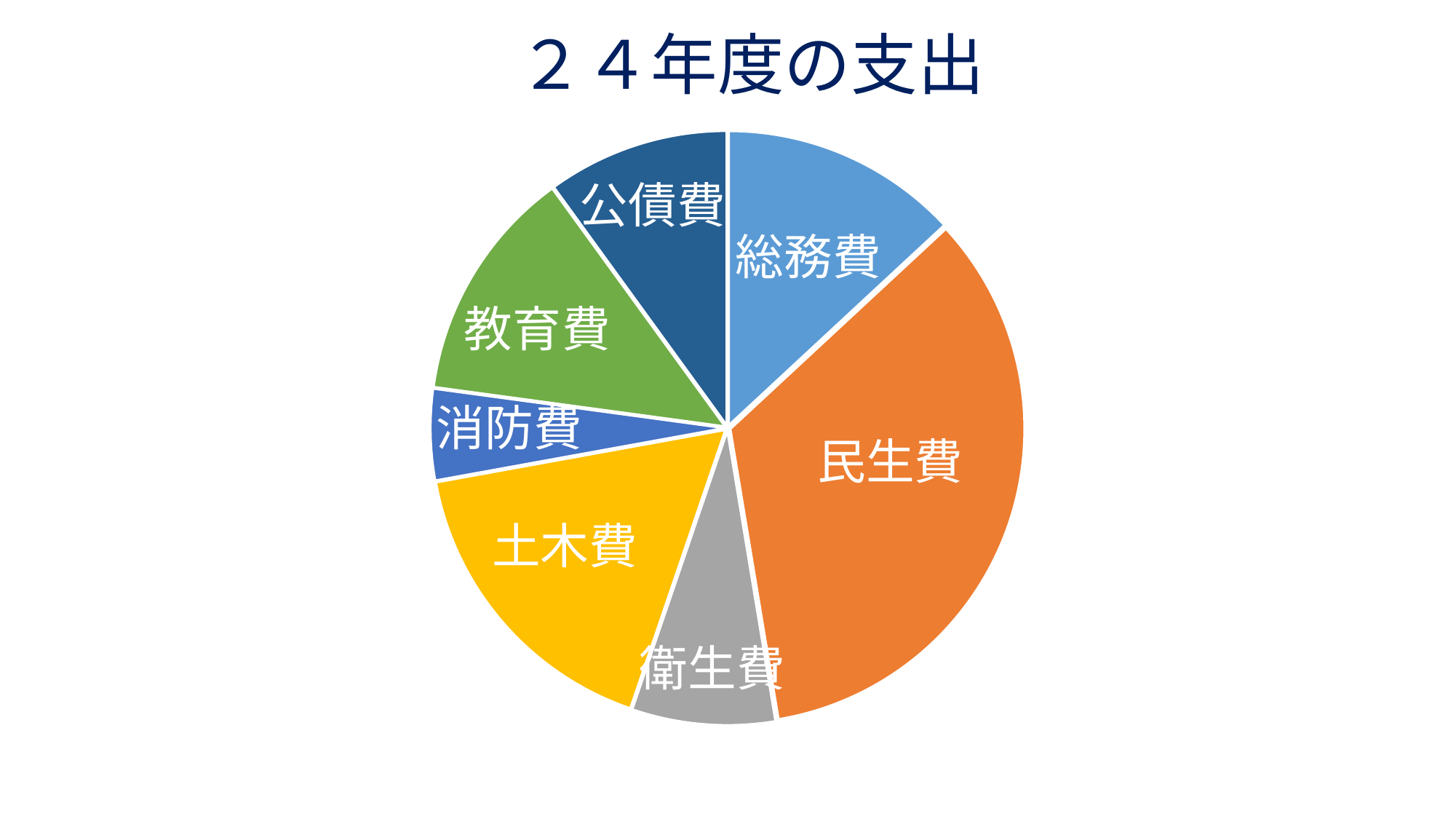
What colour is the 民生費 slice? orange Which category has the largest slice of the pie? 民生費 Which slice is larger, 民生費 or 総務費? 民生費 How many slices does the pie chart have? 7 Which slice is larger, 土木費 or 衛生費? 土木費 Which slice is larger, 民生費 or 土木費? 民生費 What is the title of the chart? ２４年度の支出 Which category has the smallest slice of the pie? 消防費 What kind of chart is shown on the slide? pie chart